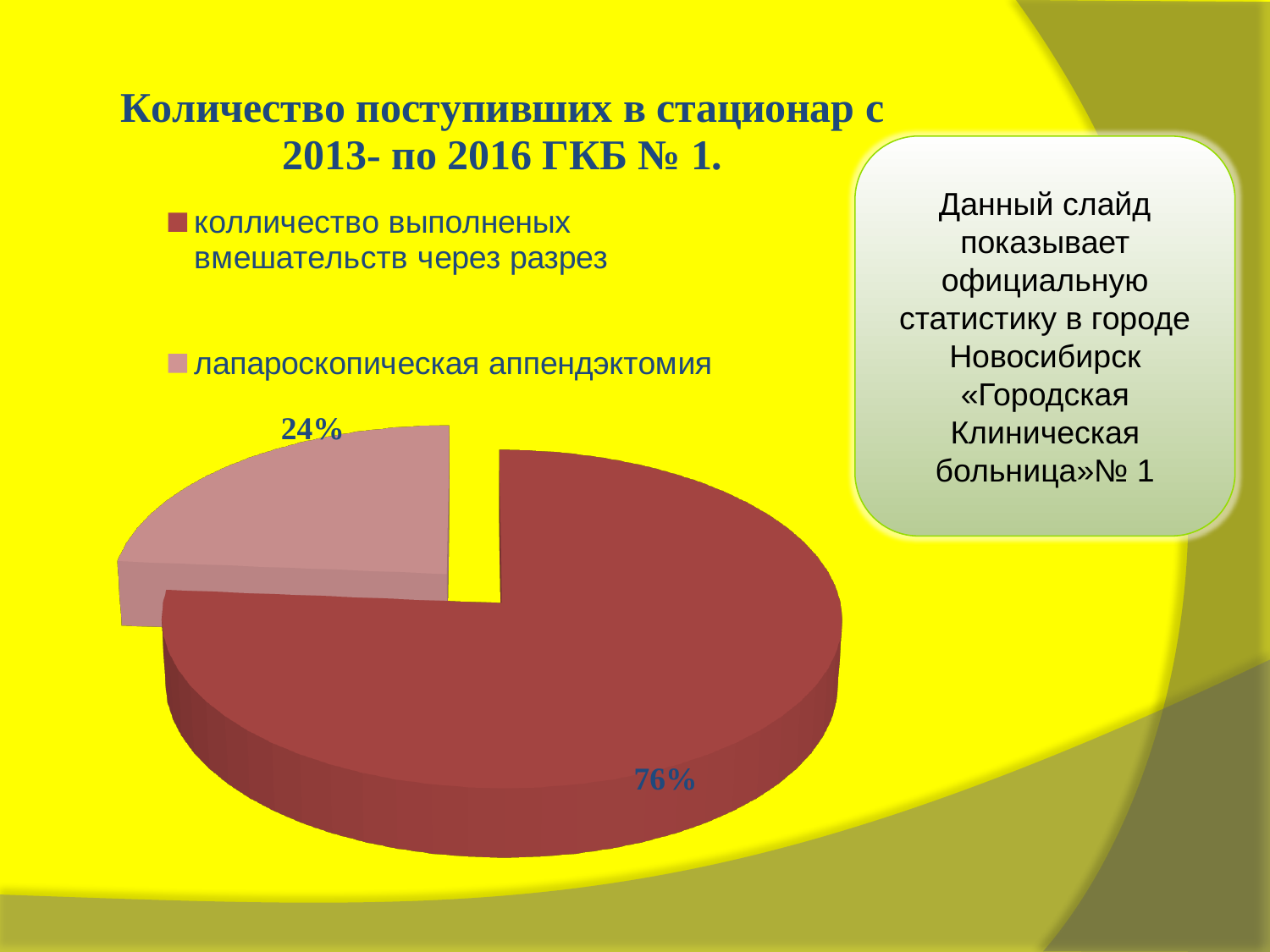
What share of the pie does "коллличество выполненых вмешательств через разрез" represent? 76% Which category has the largest slice of the pie? колличество выполненых вмешательств через разрез How many slices does the pie chart have? 2 How many entries does the legend list? 2 Which legend entry is shown in the lighter pink colour? лапароскопическая аппендэктомия Which is larger: the slice for "лапароскопическая аппендэктомия" or the slice for "коллличество выполненых вмешательств через разрез"? колличество выполненых вмешательств через разрез What kind of chart is shown on the slide? pie chart What is the title of the chart? Количество поступивших в стационар с 2013- по 2016 ГКБ № 1. What is the difference in percentage points between the two slices of the pie? 52 What share of the pie does "лапароскопическая аппендэктомия" represent? 24% Which category has the smallest slice of the pie? лапароскопическая аппендэктомия